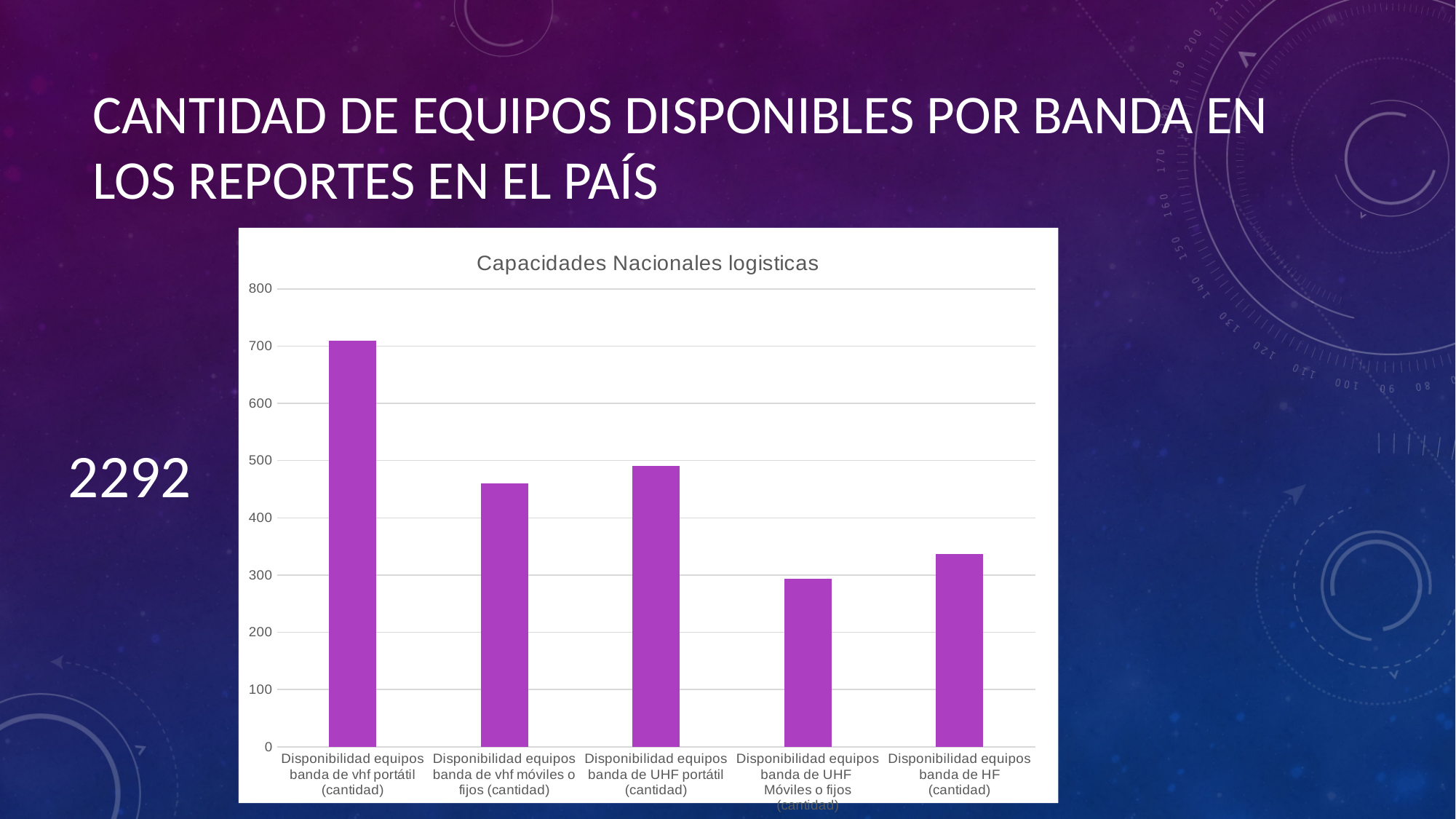
Is the value for Disponibilidad equipos banda de HF (cantidad) greater or less than 300? greater Which is larger: the value for Disponibilidad equipos banda de vhf portátil (cantidad) or for Disponibilidad equipos banda de UHF portátil (cantidad)? Disponibilidad equipos banda de vhf portátil (cantidad) Is the value for Disponibilidad equipos banda de UHF Móviles o fijos (cantidad) greater or less than 400? less Which category has the lowest value? Disponibilidad equipos banda de UHF Móviles o fijos (cantidad) Which is larger: the value for Disponibilidad equipos banda de HF (cantidad) or for Disponibilidad equipos banda de UHF Móviles o fijos (cantidad)? Disponibilidad equipos banda de HF (cantidad) Is the value for Disponibilidad equipos banda de vhf portátil (cantidad) greater or less than 600? greater What is the title of the chart? Capacidades Nacionales logisticas Which category has the highest value? Disponibilidad equipos banda de vhf portátil (cantidad) What is the maximum value shown on the vertical axis of the chart? 800 How many categories are plotted in the chart? 5 What type of chart is shown on the slide? bar chart